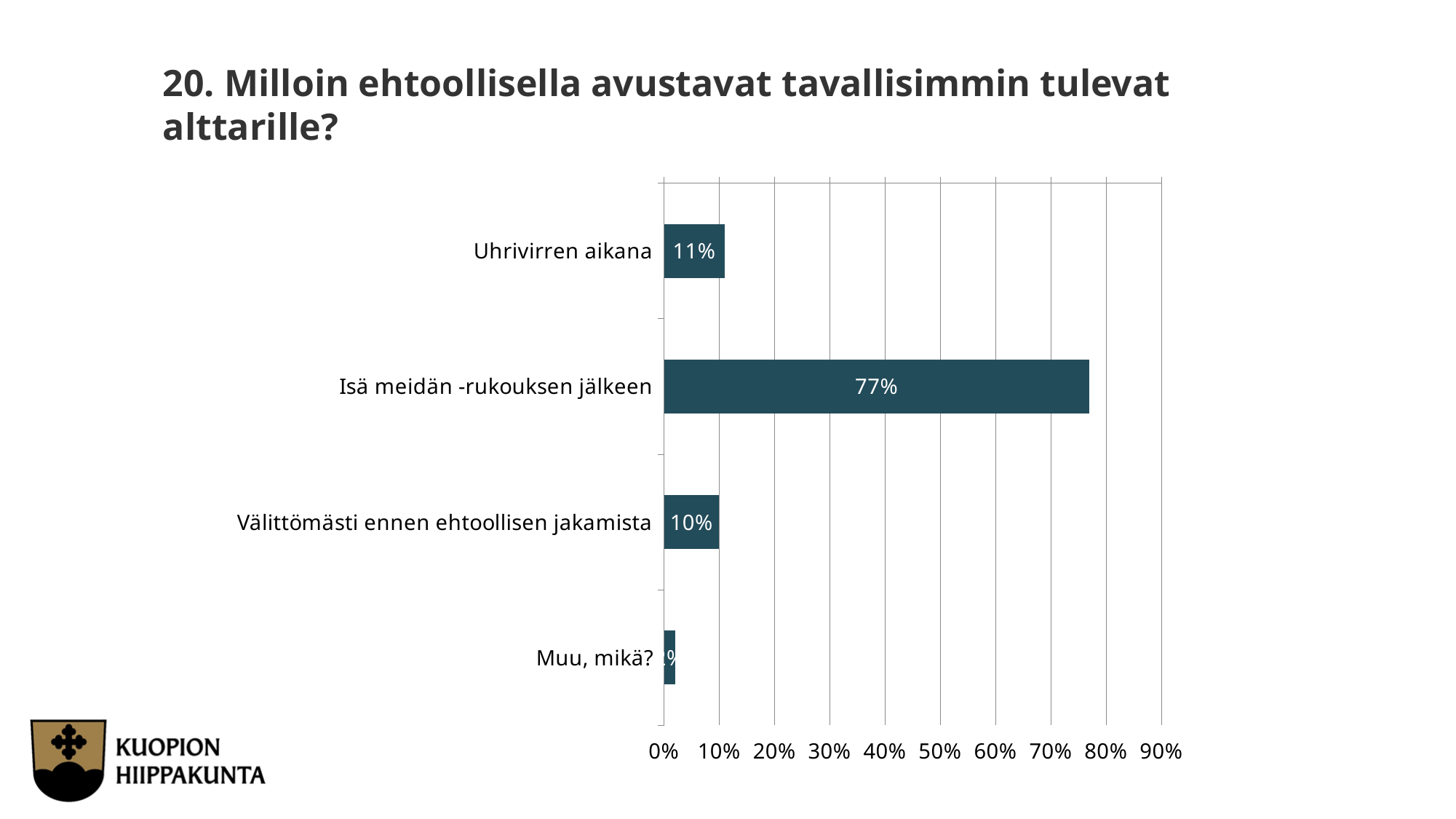
What percentage is shown for "Uhrivirren aikana"? 11% What type of chart is shown on the slide? Bar chart How many categories are shown in the chart? 4 Which category has the lowest value? Muu, mikä? Which category has the highest value? Isä meidän -rukouksen jälkeen Which is larger: the value for "Uhrivirren aikana" or the value for "Muu, mikä?"? Uhrivirren aikana What is the difference in percentage points between "Isä meidän -rukouksen jälkeen" and "Välittömästi ennen ehtoollisen jakamista"? 67 Is the value for "Muu, mikä?" greater or less than 10%? less Is the value for "Isä meidän -rukouksen jälkeen" greater or less than 70%? greater What is the difference in percentage points between "Isä meidän -rukouksen jälkeen" and "Uhrivirren aikana"? 66 What percentage is shown for "Isä meidän -rukouksen jälkeen"? 77% What percentage is shown for "Välittömästi ennen ehtoollisen jakamista"? 10%